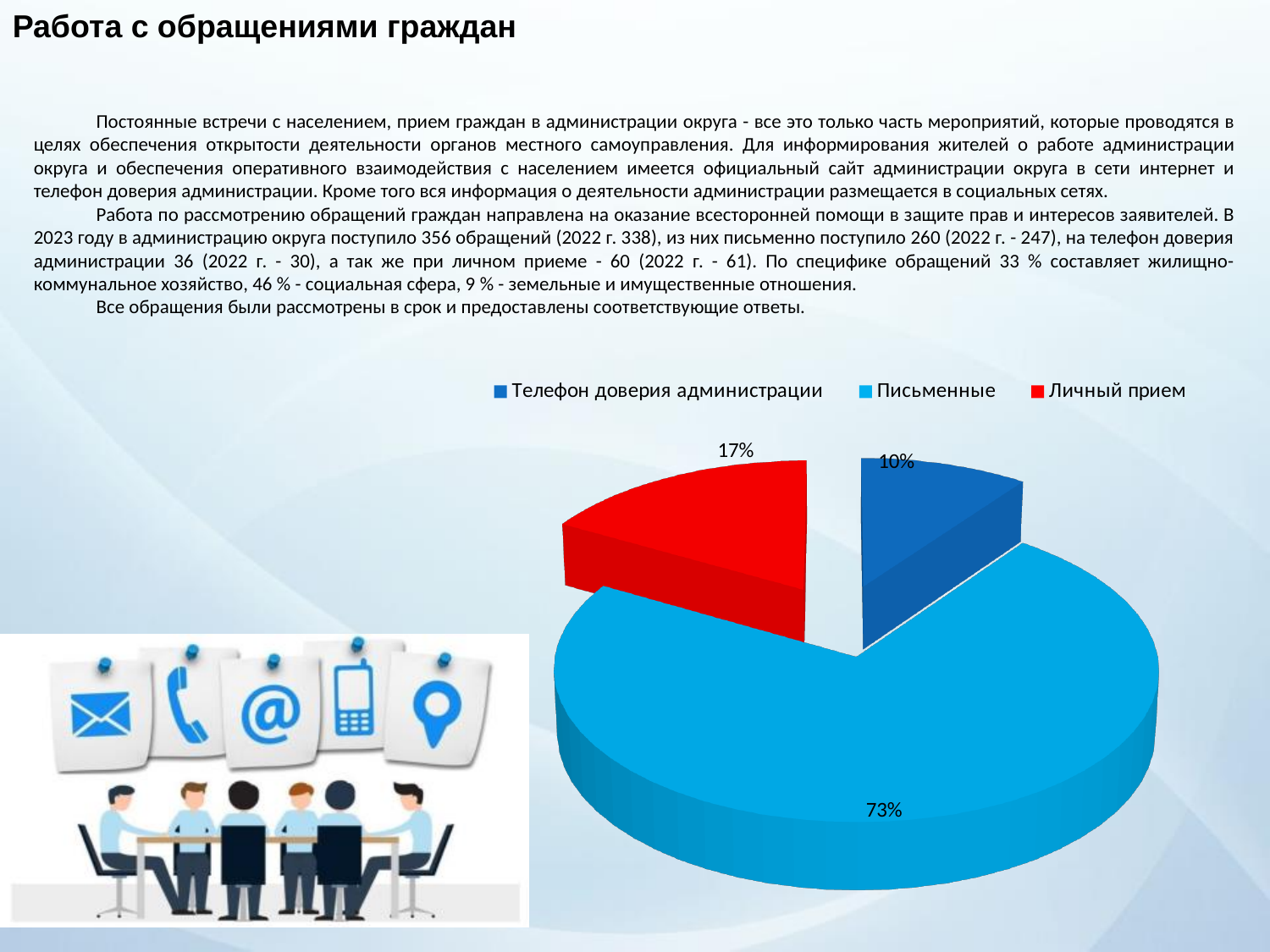
What is the difference in percentage points between the "Личный прием" and "Телефон доверия администрации" slices? 7 What kind of chart is shown on the slide? Pie chart What share of the pie does the "Личный прием" slice represent? 17% What share of the pie does the "Телефон доверия администрации" slice represent? 10% What colour is the "Личный прием" slice in the pie chart? Red What is the difference in percentage points between the "Письменные" and "Личный прием" slices? 56 Which slice is larger: "Личный прием" or "Телефон доверия администрации"? Личный прием How many slices does the pie chart have? 3 Which category has the largest slice of the pie? Письменные How many entries does the legend list? 3 Which category has the smallest slice of the pie? Телефон доверия администрации What share of the pie does the "Письменные" slice represent? 73%